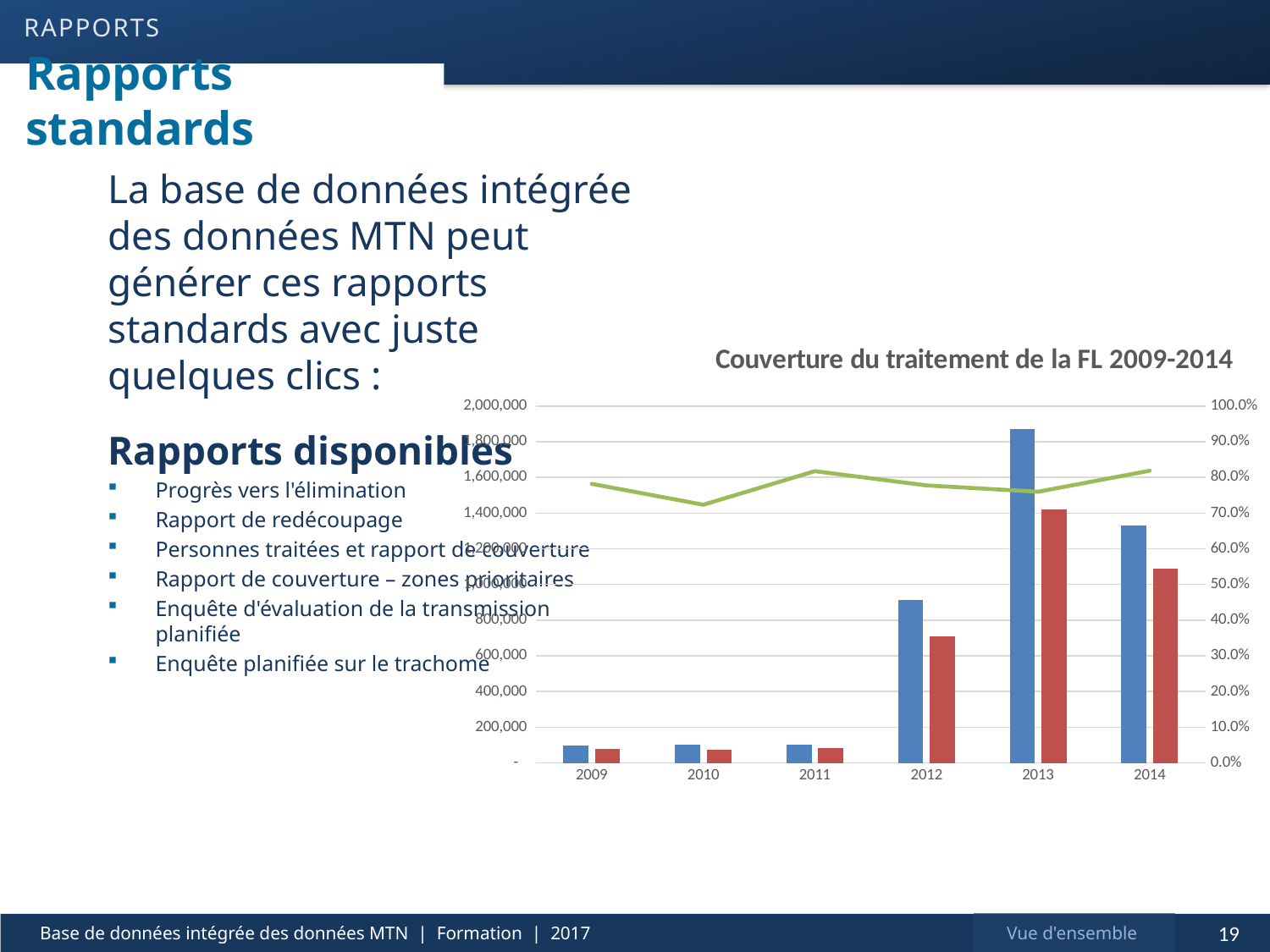
How many years are shown on the x axis of the chart? 6 In which year is the blue bar the tallest? 2013 What is the title of the chart on the slide? Couverture du traitement de la FL 2009-2014 In which year is the red bar the tallest? 2013 In 2013, which bar is taller, the blue bar or the red bar? The blue bar Is the value of the blue bar for 2012 greater or less than 1,000,000? less What is the highest value shown on the right-hand axis of the chart? 100.0% What kind of chart is shown on the slide? A combined bar and line chart Is the green line's value for 2010 greater or less than 80.0%? less Is the value of the red bar for 2014 greater or less than 1,000,000? greater